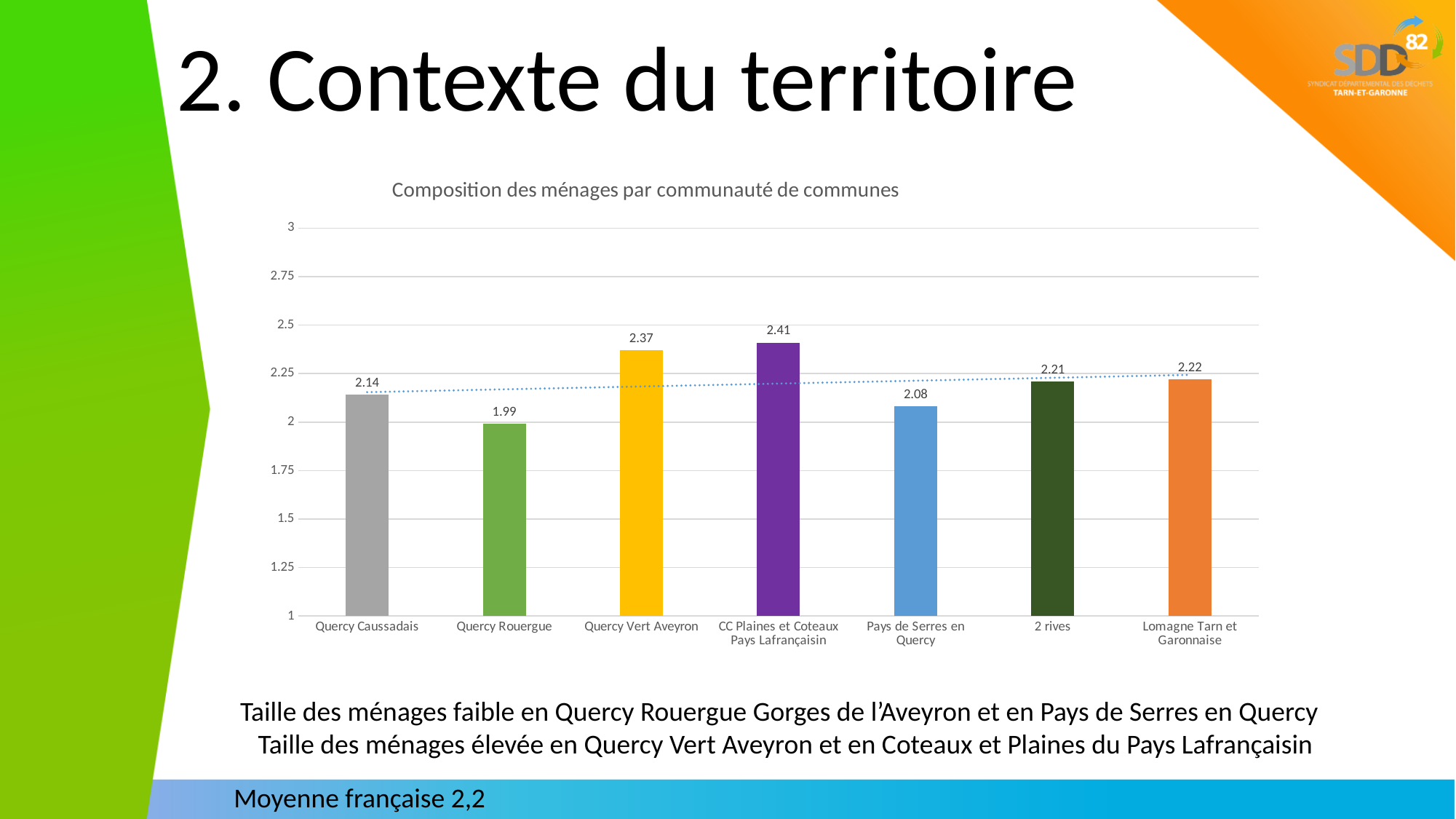
Which community of communes has the highest value? CC Plaines et Coteaux Pays Lafrançaisin Is the value for Pays de Serres en Quercy greater or less than 2.25? less What is the title of the chart? Composition des ménages par communauté de communes Which community of communes has the lowest value? Quercy Rouergue What kind of chart is shown on the slide? bar chart Which is larger, the value for 2 rives or the value for Quercy Caussadais? 2 rives How many communities of communes are shown on the chart? 7 What is the value for Lomagne Tarn et Garonnaise? 2.22 What is the value for Quercy Caussadais? 2.14 What is the value for Quercy Rouergue? 1.99 What is the difference between the values for Quercy Vert Aveyron and Pays de Serres en Quercy? 0.29 What is the value for CC Plaines et Coteaux Pays Lafrançaisin? 2.41